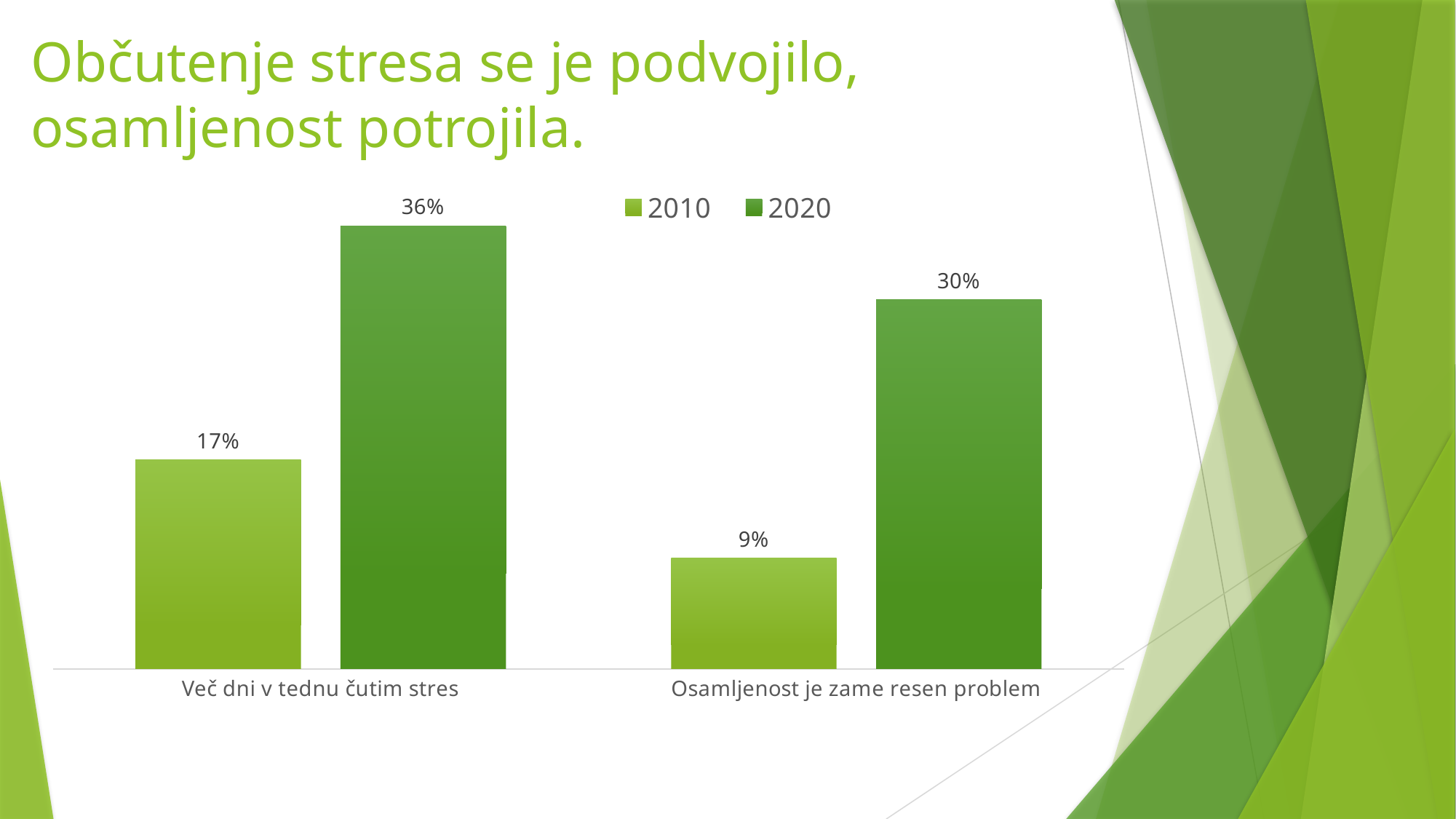
How many categories are shown on the x axis? 2 Which is larger: the 2020 value for "Več dni v tednu čutim stres" or the 2020 value for "Osamljenost je zame resen problem"? Več dni v tednu čutim stres What is the 2020 value for "Osamljenost je zame resen problem"? 30% What is the difference between the 2020 and 2010 values for "Več dni v tednu čutim stres"? 19% How many series does the legend list? 2 What is the difference between the 2020 and 2010 values for "Osamljenost je zame resen problem"? 21% Which bar has the lowest value on the chart? 2010, Osamljenost je zame resen problem Which bar has the highest value on the chart? 2020, Več dni v tednu čutim stres What is the 2010 value for "Osamljenost je zame resen problem"? 9% What kind of chart is shown on the slide? Bar chart What is the 2010 value for "Več dni v tednu čutim stres"? 17% What is the 2020 value for "Več dni v tednu čutim stres"? 36%